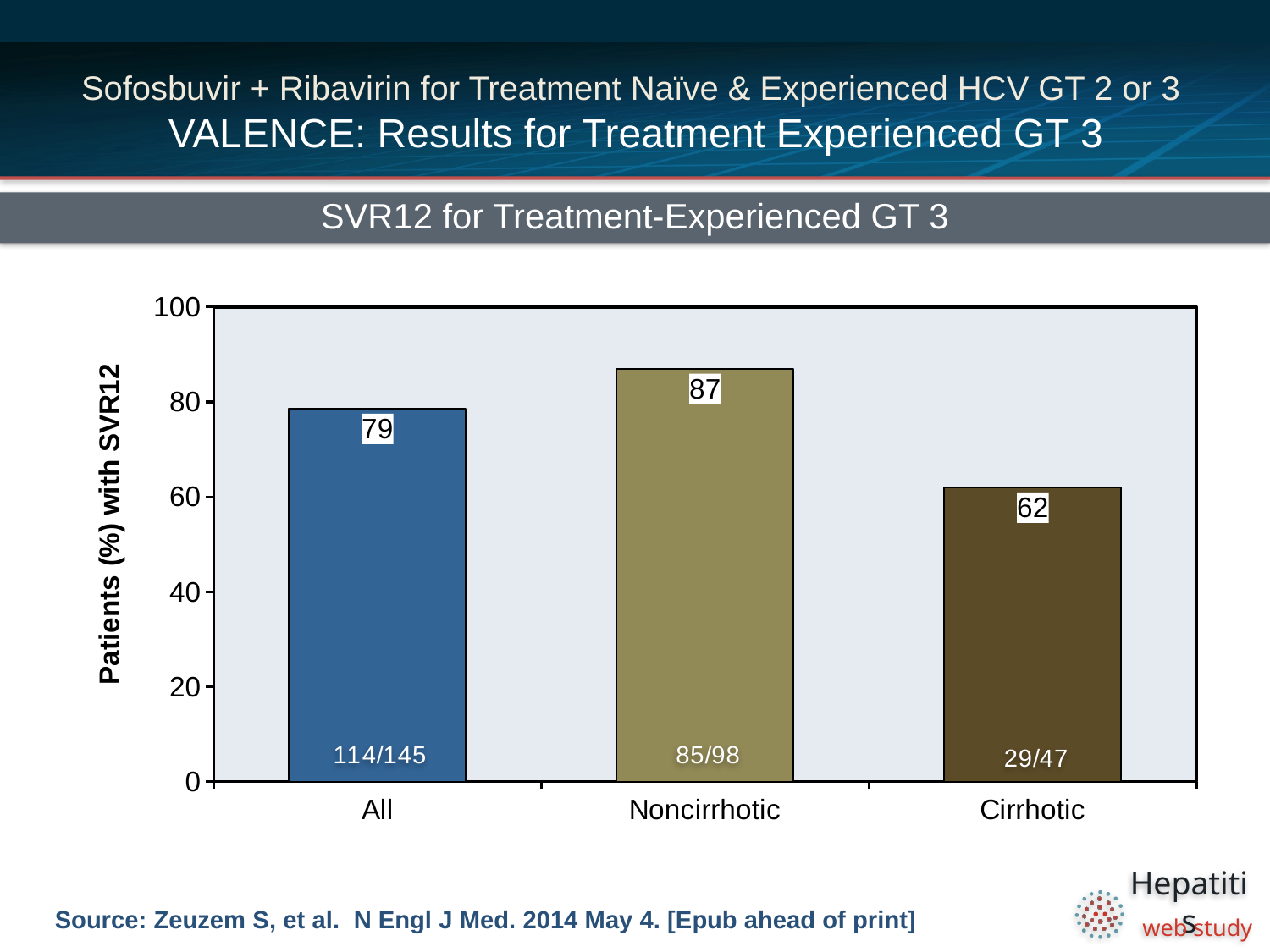
Which group has the lowest SVR12 percentage? Cirrhotic What is the SVR12 percentage for the Cirrhotic group? 62 How many groups are shown on the x axis? 3 Which group has the highest SVR12 percentage? Noncirrhotic What kind of chart is shown on the slide? Bar chart What is the SVR12 percentage for the All group? 79 What is the title of the chart? SVR12 for Treatment-Experienced GT 3 What is the difference in SVR12 percentage between the Noncirrhotic and Cirrhotic groups? 25 What is the SVR12 percentage for the Noncirrhotic group? 87 Is the SVR12 value for the Cirrhotic group greater or less than 80? less Which group has a higher SVR12 percentage, All or Cirrhotic? All What fraction of patients is shown inside the Noncirrhotic bar? 85/98